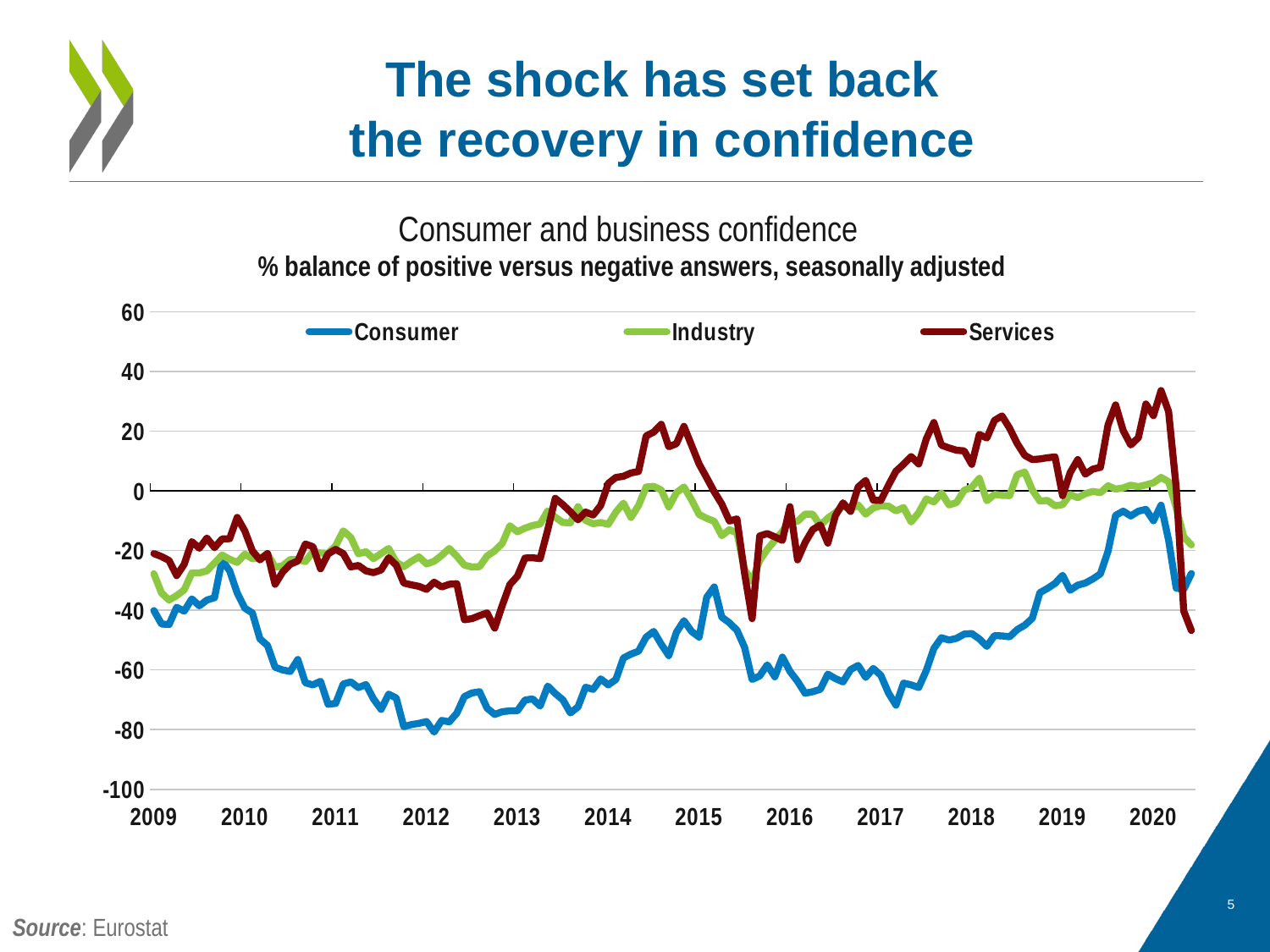
What colour is the Services line in the chart? Dark red Is the Consumer value at the start of 2012 greater or less than -60? less Does the Consumer series generally rise or fall between 2012 and 2019? Rise Is the Services value at the start of 2020 greater or less than 20? greater Which series reaches the lowest value anywhere on the chart? Consumer How many series does the legend list? 3 What is the title of the chart? Consumer and business confidence In 2012, which series is higher, Industry or Consumer? Industry How many year labels are shown on the x axis? 12 Is the Consumer value at the start of 2009 greater or less than -20? less Which series reaches the highest value anywhere on the chart? Services What kind of chart is shown on the slide? Line chart